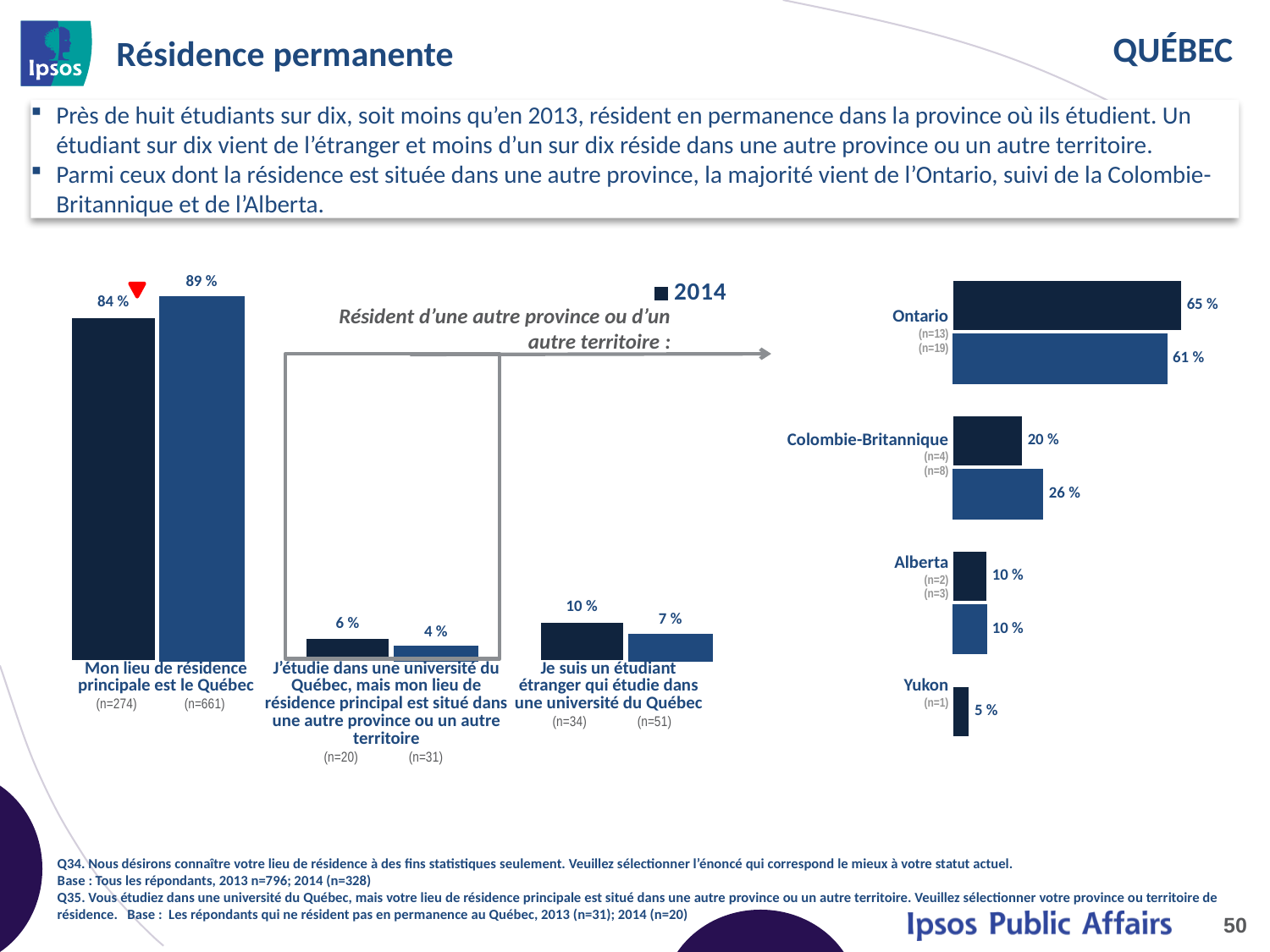
What kind of chart is the left chart? Bar chart In the right chart, what is the difference between the two bars for Ontario? 4 % In the left chart, what is the difference between the two bars for 'Mon lieu de résidence principale est le Québec'? 5 % In the left chart, what is the value of the lighter blue bar for 'Mon lieu de résidence principale est le Québec'? 89 % In the left chart, which category has the highest 2014 value? Mon lieu de résidence principale est le Québec In the right chart, which province or territory has the highest value? Ontario In the right chart, what is the 2014 (dark blue) value for Ontario? 65 % In the left chart, what is the 2014 value for 'Je suis un étudiant étranger qui étudie dans une université du Québec'? 10 % In the left chart, what is the 2014 value for 'Mon lieu de résidence principale est le Québec'? 84 % In the left chart, how many categories are shown on the x axis? 3 In the right chart, what is the value of the lighter blue bar for Colombie-Britannique? 26 % In the right chart, what is the value shown for Yukon? 5 %